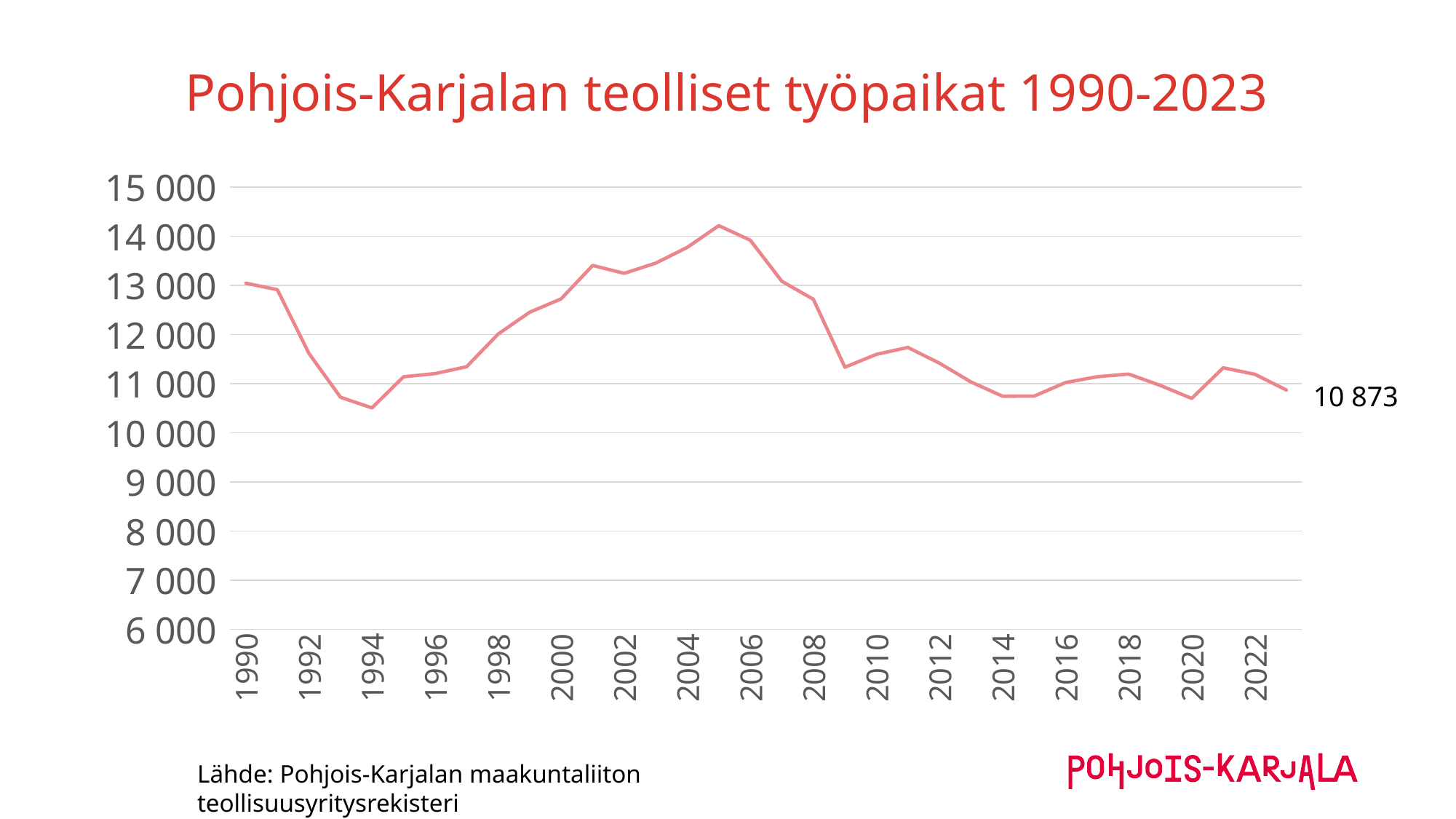
Is the value for 2009 greater or less than 12 000? less In which year does the line reach its highest value? 2005 What kind of chart is shown on the slide? line chart What is the title of the chart? Pohjois-Karjalan teolliset työpaikat 1990-2023 Which year has the larger value, 1994 or 2000? 2000 What is the value shown for 2023 on the chart? 10 873 Do the values rise or fall between 2005 and 2009? fall Is the value for 1994 greater or less than 11 000? less Is the value for 2005 greater or less than 13 000? greater What is the highest value labelled on the vertical axis? 15 000 Which year has the larger value, 1990 or 2023? 1990 In which year does the line reach its lowest value? 1994